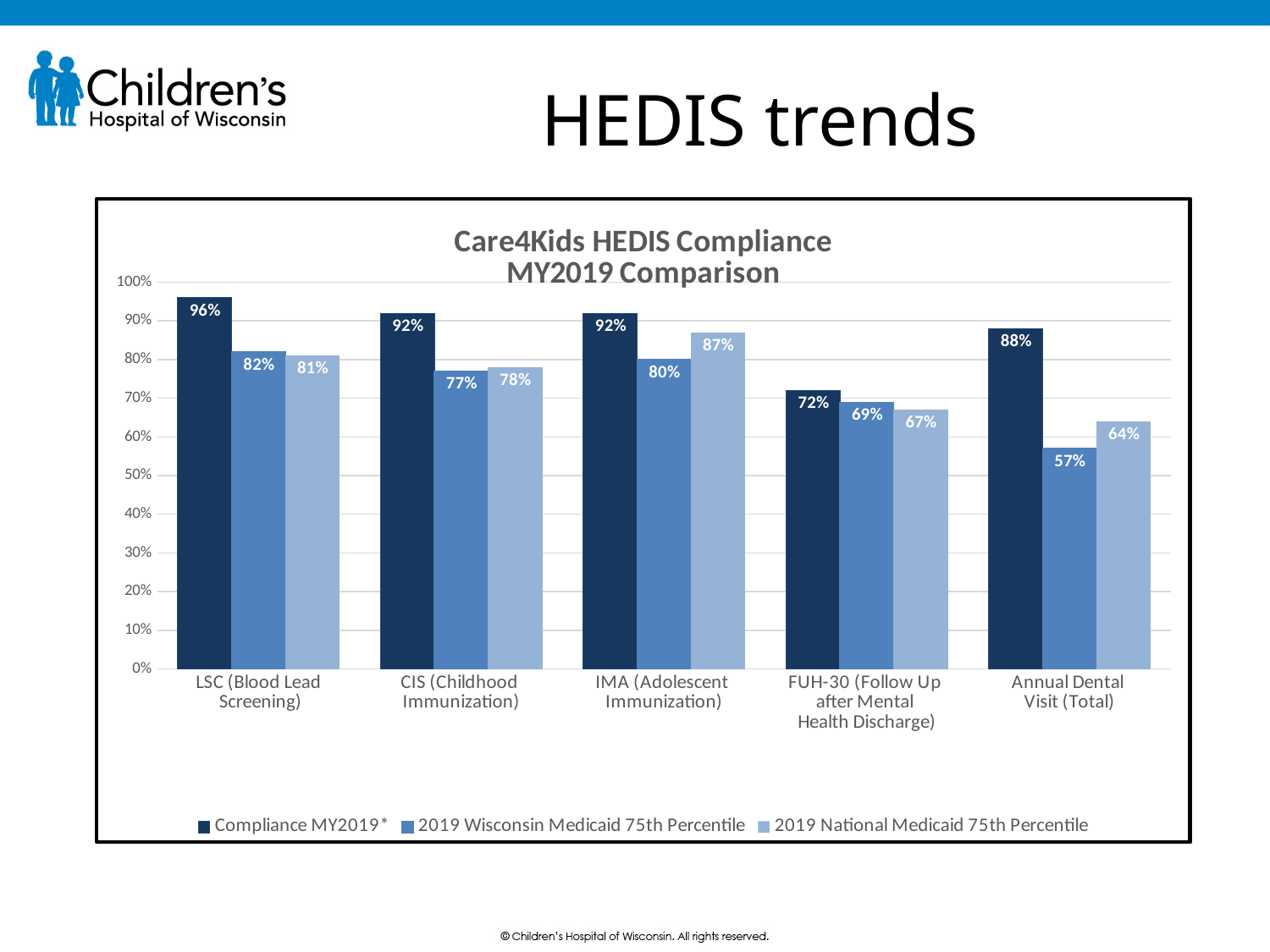
How many categories are shown on the x axis? 5 What kind of chart is shown on the slide? Bar chart What is the Compliance MY2019* value for LSC (Blood Lead Screening)? 96% What is the title of the chart? Care4Kids HEDIS Compliance MY2019 Comparison What is the 2019 National Medicaid 75th Percentile value for IMA (Adolescent Immunization)? 87% For CIS (Childhood Immunization), which is larger: the 2019 Wisconsin Medicaid 75th Percentile or the 2019 National Medicaid 75th Percentile? 2019 National Medicaid 75th Percentile Which category has the highest Compliance MY2019* value? LSC (Blood Lead Screening) Is the Compliance MY2019* value for FUH-30 (Follow Up after Mental Health Discharge) greater or less than 80%? less How many series does the legend list? 3 What is the 2019 Wisconsin Medicaid 75th Percentile value for Annual Dental Visit (Total)? 57% What is the difference between the Compliance MY2019* value and the 2019 Wisconsin Medicaid 75th Percentile value for Annual Dental Visit (Total)? 31% Which category has the lowest 2019 Wisconsin Medicaid 75th Percentile value? Annual Dental Visit (Total)